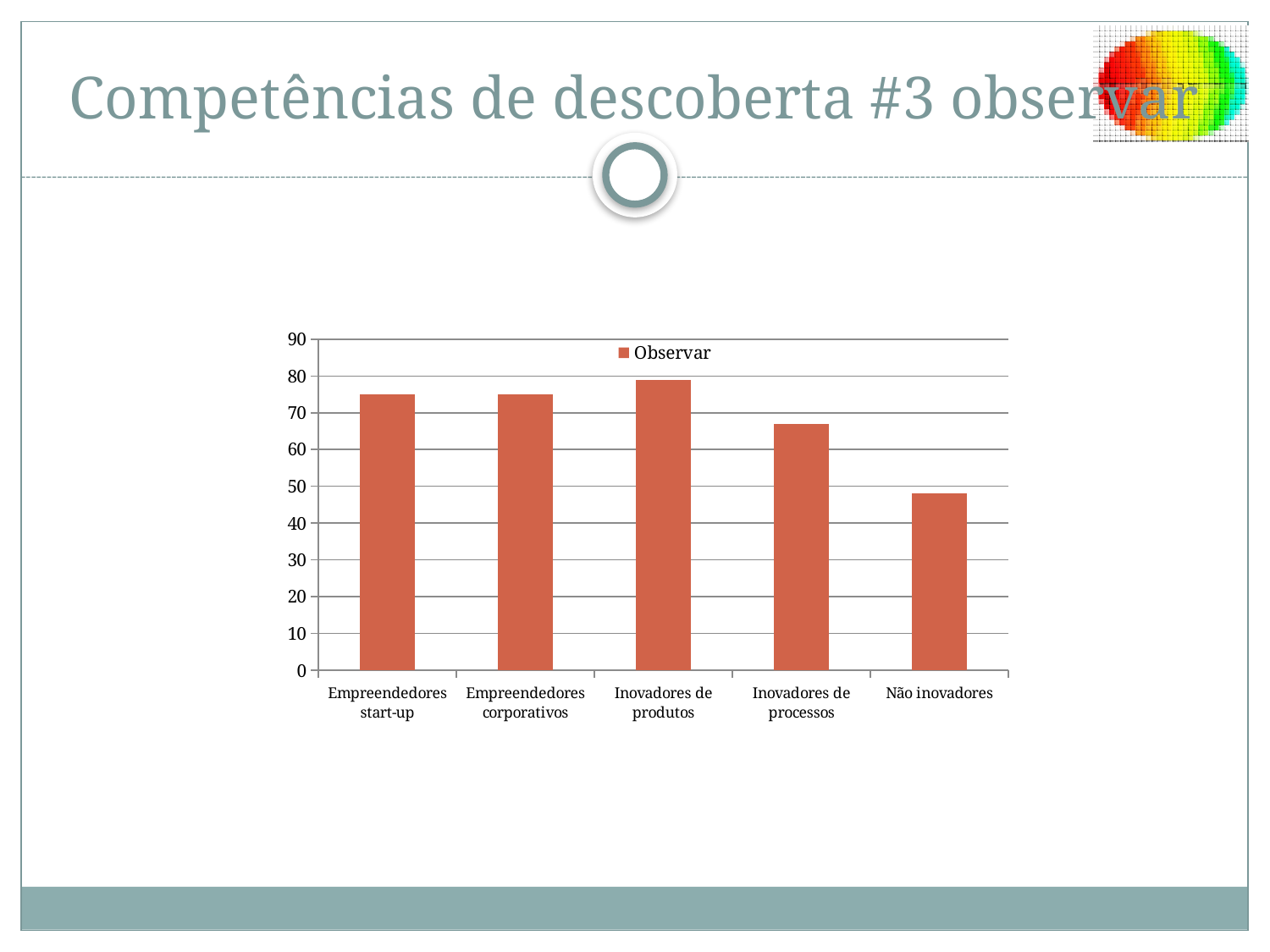
How many series does the chart legend list? 1 Is the value for Empreendedores corporativos greater or less than 80? less Which is larger, the value for Inovadores de produtos or the value for Inovadores de processos? Inovadores de produtos Which is larger, the value for Não inovadores or the value for Inovadores de processos? Inovadores de processos How many categories are shown on the x axis of the chart? 5 What kind of chart is shown on the slide? bar chart What is the name of the series shown in the chart legend? Observar Is the value for Inovadores de processos greater or less than 60? greater Which category has the highest value in the chart? Inovadores de produtos Is the value for Empreendedores start-up greater or less than 70? greater Which category has the lowest value in the chart? Não inovadores